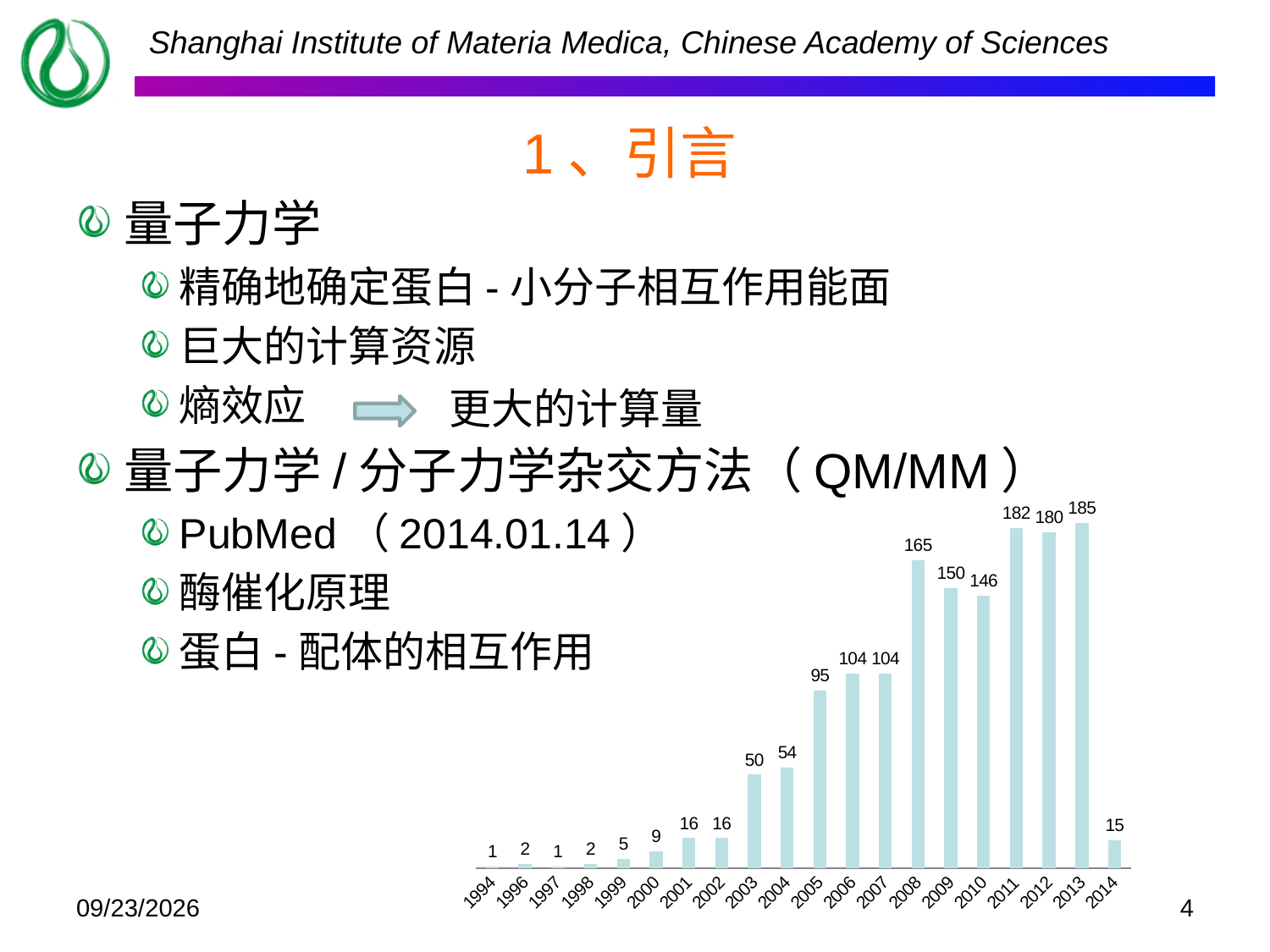
What kind of chart is shown on the slide? bar chart What value is shown for 2008 in the bar chart? 165 What value is shown for 2014 in the bar chart? 15 What value is shown for 2003 in the bar chart? 50 Which is larger in the bar chart, the value for 2009 or the value for 2010? 2009 What value is shown for 2013 in the bar chart? 185 Which year has the highest value in the bar chart? 2013 What is the difference between the values for 2005 and 2004 in the bar chart? 41 What is the difference between the values for 2011 and 2010 in the bar chart? 36 Do the values in the bar chart generally rise or fall from 1994 to 2013? rise How many years are shown on the x axis of the bar chart? 20 Which is larger in the bar chart, the value for 2008 or the value for 2007? 2008